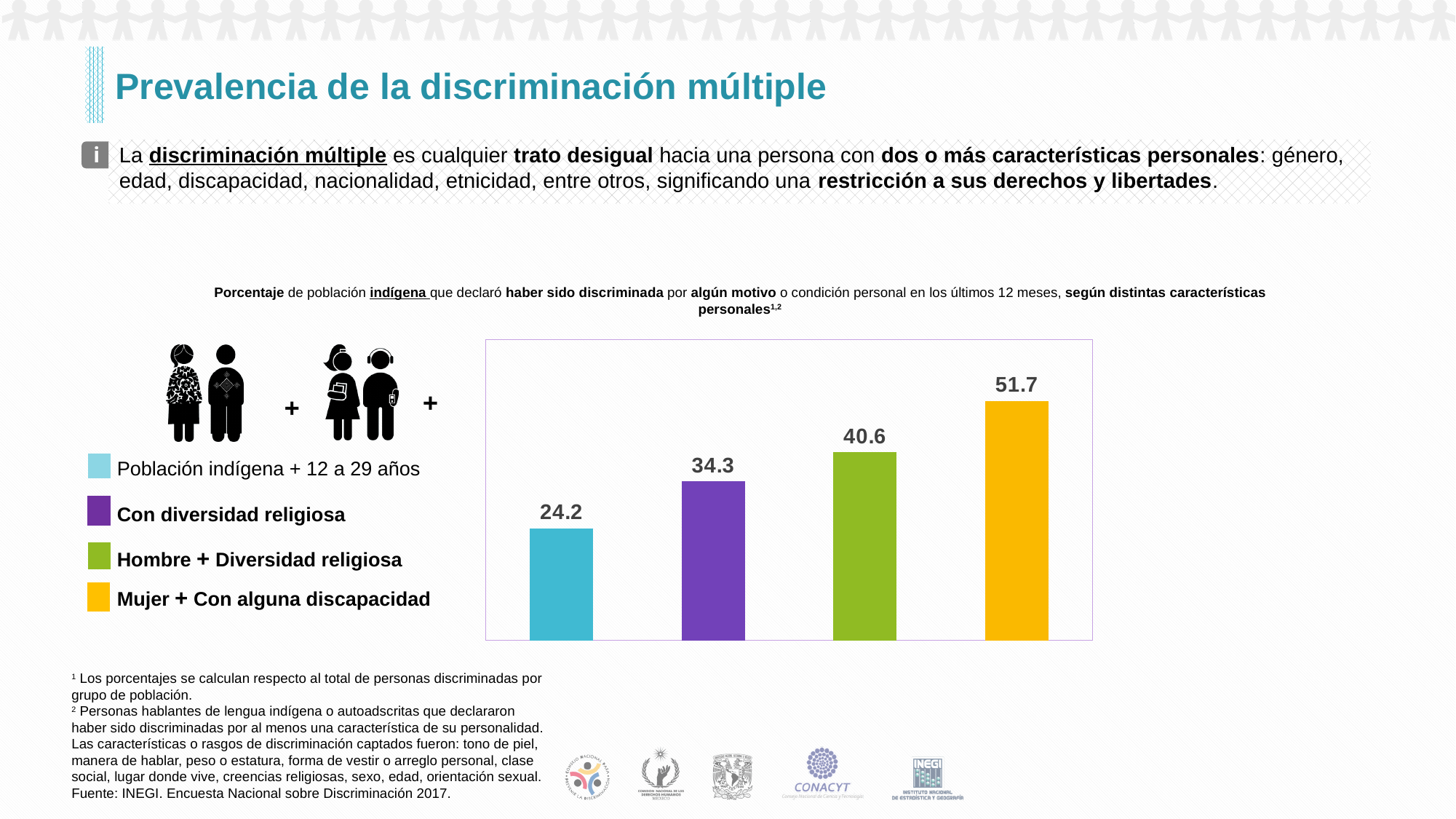
Do the values rise or fall from left to right across the bars? Rise What is the difference between 'Hombre + Diversidad religiosa' and 'Con diversidad religiosa'? 6.3 Which category has the highest value? Mujer + Con alguna discapacidad What is the value for 'Mujer + Con alguna discapacidad'? 51.7 What is the difference between 'Mujer + Con alguna discapacidad' and 'Población indígena + 12 a 29 años'? 27.5 How many bars are shown in the chart? 4 Which category has the lowest value? Población indígena + 12 a 29 años What is the value for 'Con diversidad religiosa'? 34.3 Which is larger: 'Con diversidad religiosa' or 'Hombre + Diversidad religiosa'? Hombre + Diversidad religiosa What kind of chart is shown on the slide? Bar chart What is the value for 'Hombre + Diversidad religiosa'? 40.6 What is the value for 'Población indígena + 12 a 29 años'? 24.2